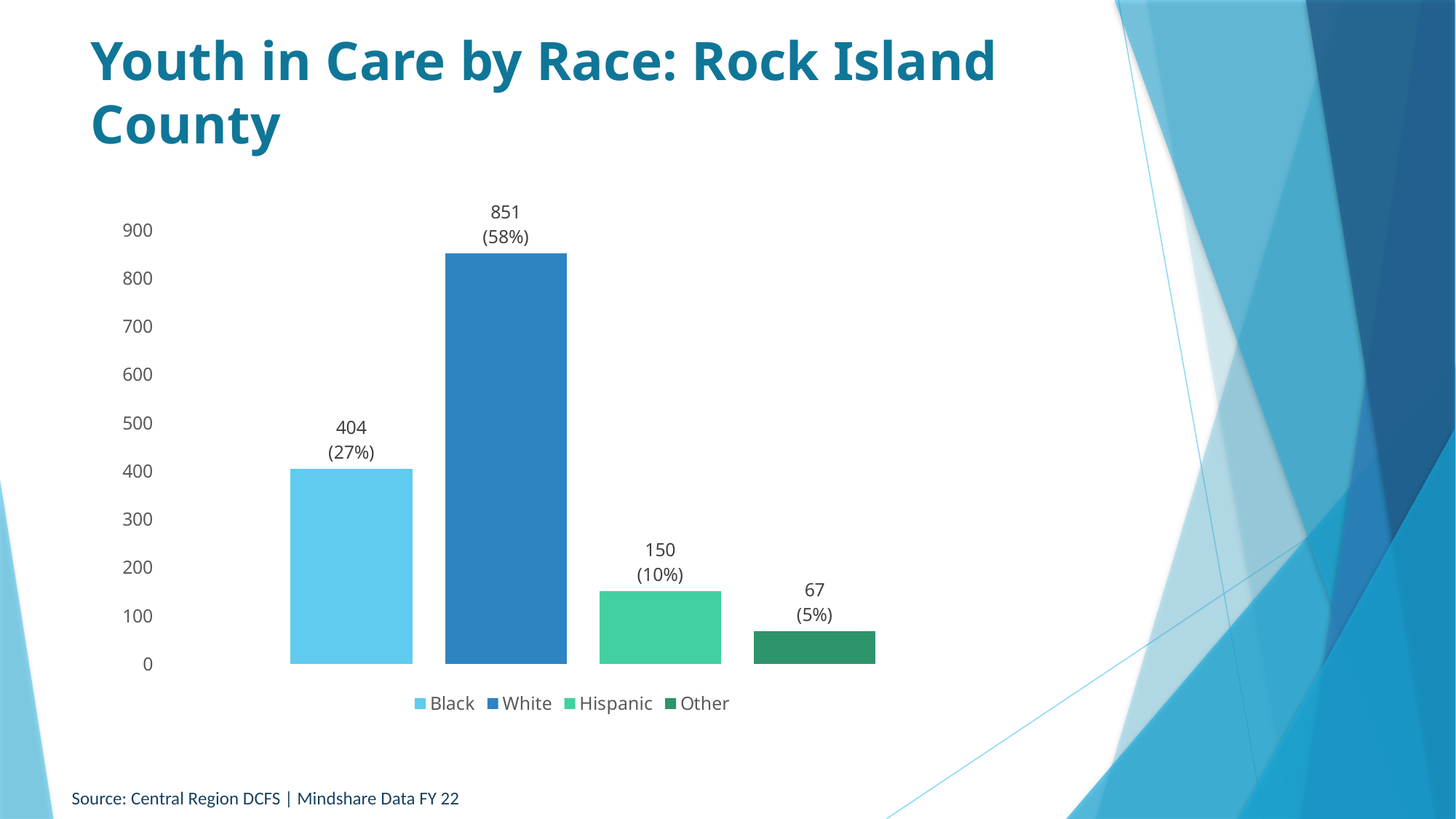
What percentage is shown for the Hispanic category? 10% What is the value shown for the Other category? 67 Which is larger, the value for Hispanic or the value for Other? Hispanic What is the title of the slide? Youth in Care by Race: Rock Island County Which category has the lowest number of youth in care? Other What is the number of youth in care for the White category? 851 How many entries does the legend list? 4 How many categories are shown in the chart? 4 What is the number of youth in care for the Black category? 404 What is the difference between the White and Black values? 447 What kind of chart is shown on the slide? Bar chart Which category has the highest number of youth in care? White